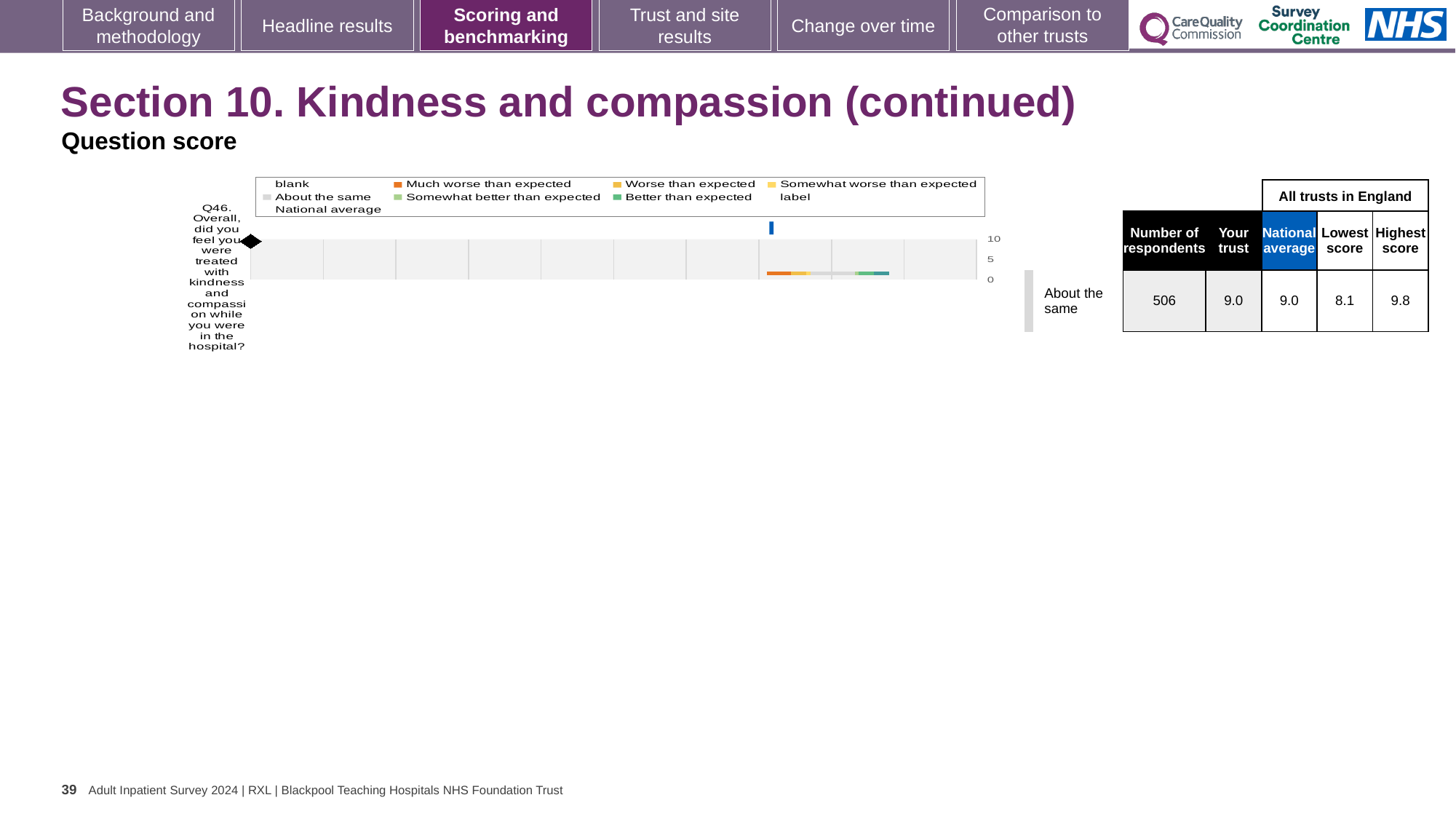
Which legend entry is shown in orange on the chart? Much worse than expected How many survey questions are plotted on the chart? 1 What is the highest score among all trusts in England for Q46? 9.8 What is the 'Your trust' score for Q46 in the table beside the chart? 9.0 What is the national average score for Q46 shown in the table beside the chart? 9.0 What is the highest value shown on the chart's score axis? 10 What is the difference between the highest score and the lowest score for Q46? 1.7 What is the lowest score among all trusts in England for Q46? 8.1 How many respondents answered Q46 according to the table beside the chart? 506 What kind of chart is used to show the Q46 question score? bar chart Is the trust's score for Q46 greater or less than 5 on the chart's axis? greater What benchmark category is given for Q46 next to the chart? About the same